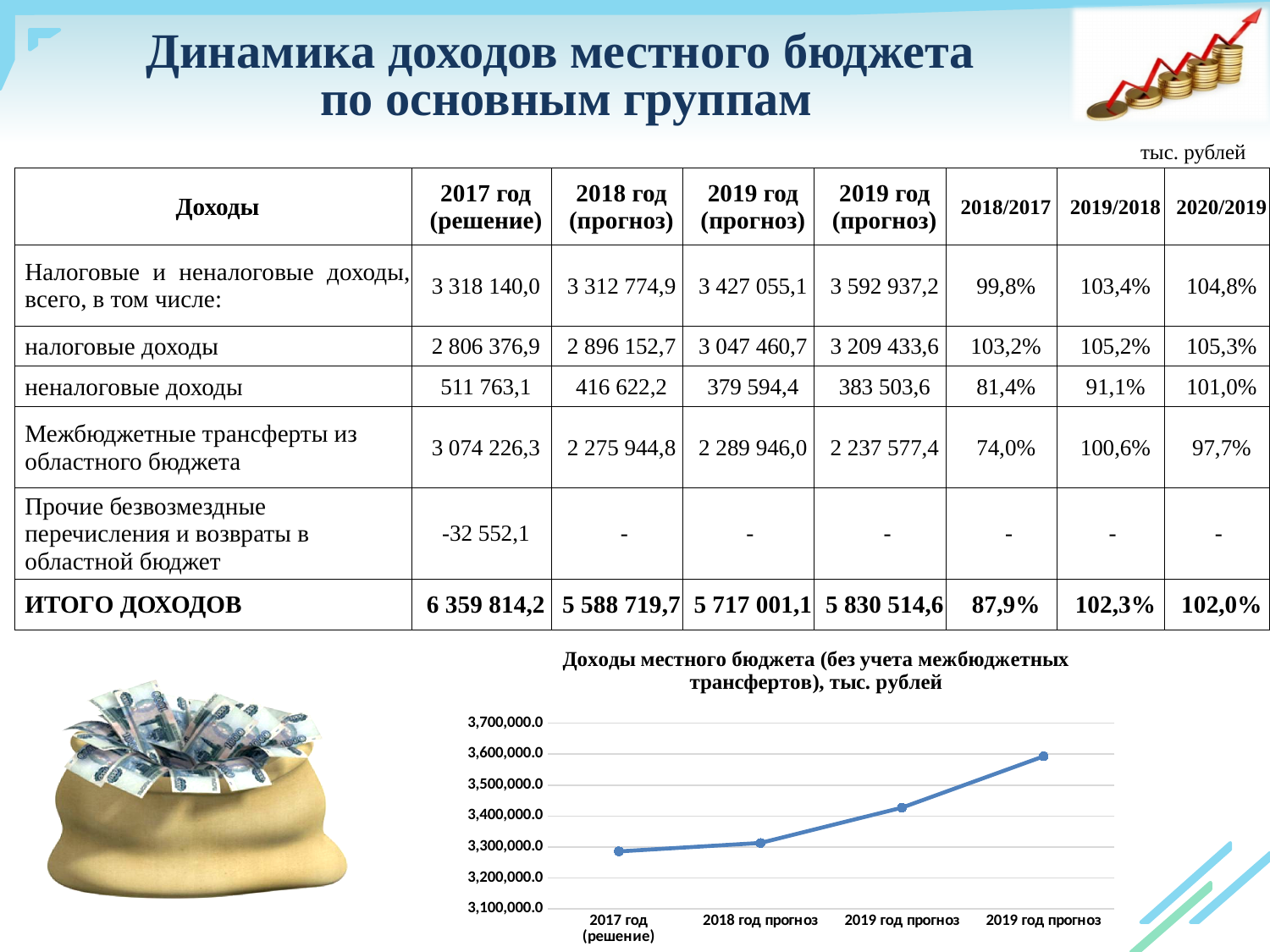
On the line chart, is the value of the third point (first 2019 год прогноз) greater or less than 3,400,000.0? greater On the line chart, is the value of the last point greater or less than 3,700,000.0? less On the line chart, is the value for 2018 год прогноз greater or less than 3,400,000.0? less How many data points are plotted on the line chart? 4 Which x-axis category has the lowest value on the line chart? 2017 год (решение) What is the title of the chart at the bottom of the slide? Доходы местного бюджета (без учета межбюджетных трансфертов), тыс. рублей Do the values on the line chart rise or fall from left to right along the x axis? rise What kind of chart is shown at the bottom of the slide? line chart Which point on the line chart has the highest value, the first or the last? the last On the line chart, which is larger: the value for 2018 год прогноз or the value of the last point? the last point